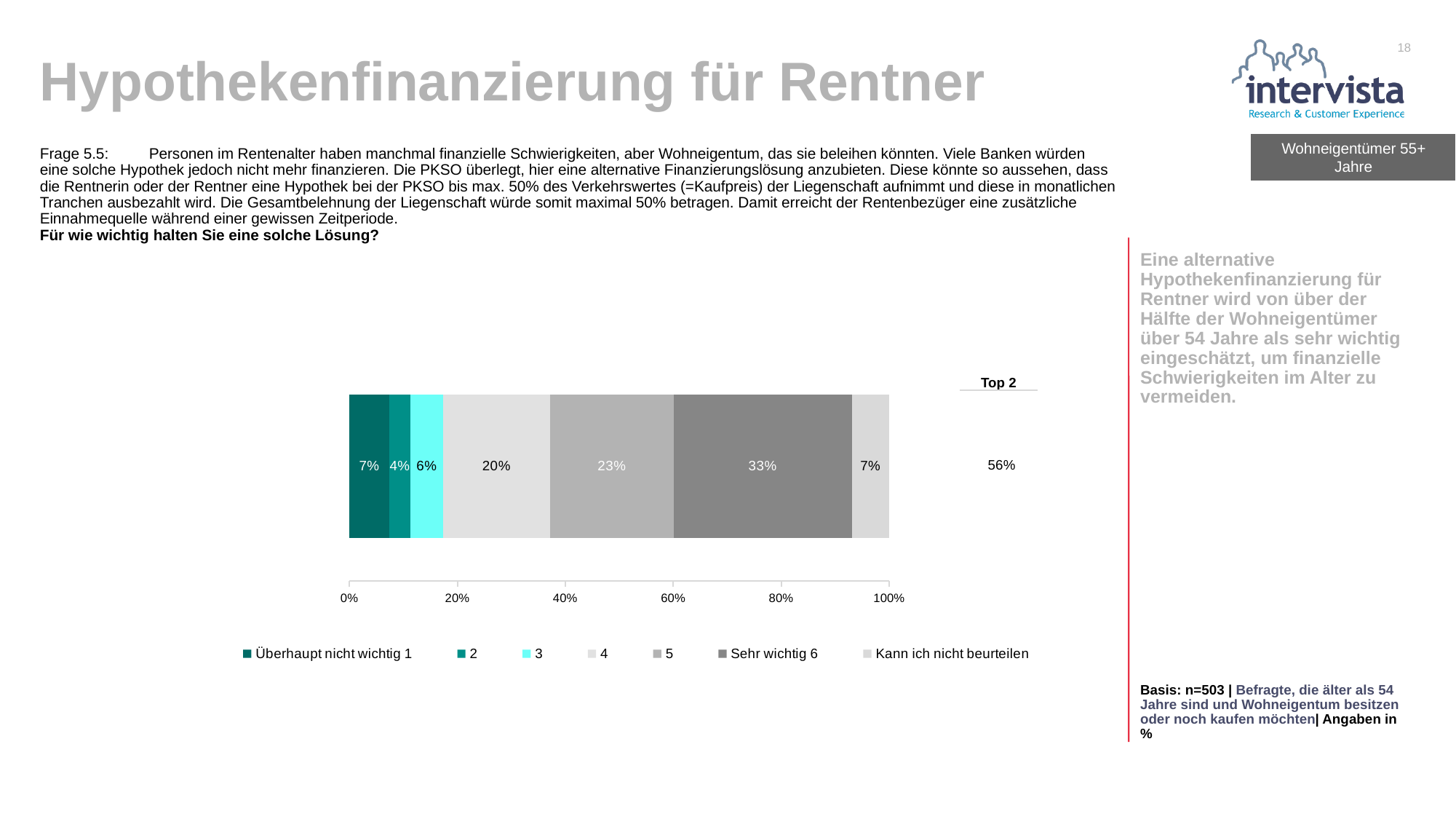
What percentage of respondents answered "Sehr wichtig 6"? 33% How many series does the legend list? 7 Which response category has the largest share of the bar? Sehr wichtig 6 Which response category has the smallest share of the bar? 2 What is the difference between the share for rating 5 and the share for rating 4? 3% What percentage of respondents answered "Überhaupt nicht wichtig 1"? 7% Which is larger, the share for rating 3 or the share for rating 2? 3 What is the Top 2 value shown next to the bar? 56% What percentage of respondents answered "Kann ich nicht beurteilen"? 7% What is the combined share of ratings 5 and "Sehr wichtig 6"? 56% What kind of chart is shown on the slide? Stacked bar chart What percentage of respondents chose rating 4? 20%